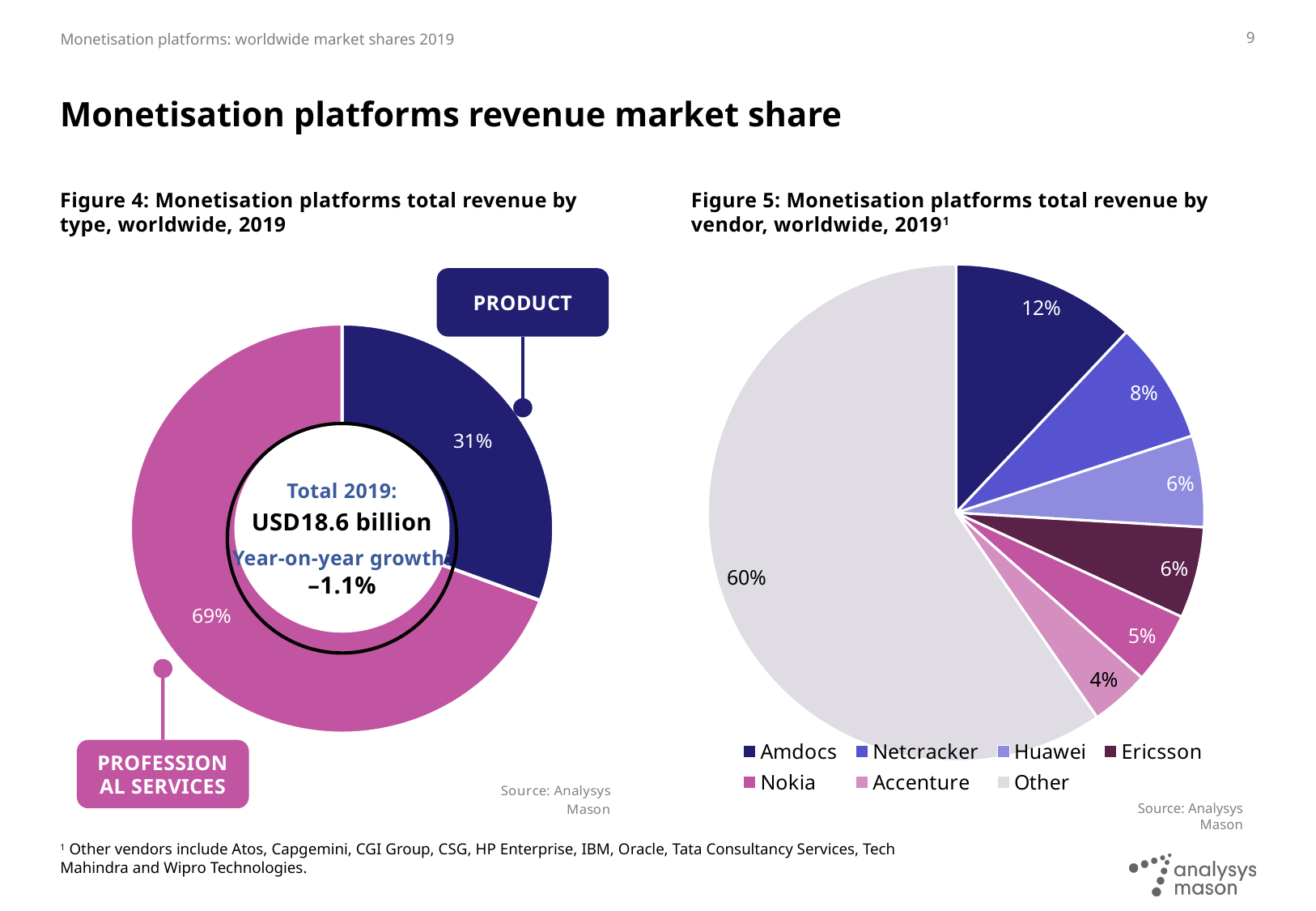
In Figure 5, what is the difference in percentage points between the Amdocs share and the Nokia share? 7 In Figure 5, what share of revenue does Amdocs hold? 12% In Figure 5, how many vendor categories does the legend list? 7 In Figure 4, which revenue type has the larger share, Product or Professional Services? Professional Services In Figure 4, what is the total 2019 revenue shown in the centre of the chart? USD18.6 billion In Figure 4, what share of monetisation platforms total revenue comes from Product? 31% In Figure 5, which vendor has the smallest share? Accenture In Figure 5, which named vendor (excluding Other) has the largest share? Amdocs In Figure 4, what year-on-year growth is shown in the centre of the chart? –1.1% In Figure 4, what is the difference in percentage points between the Professional Services share and the Product share? 38 In Figure 4, what share of monetisation platforms total revenue comes from Professional Services? 69% In Figure 5, what share of revenue does Netcracker hold? 8%